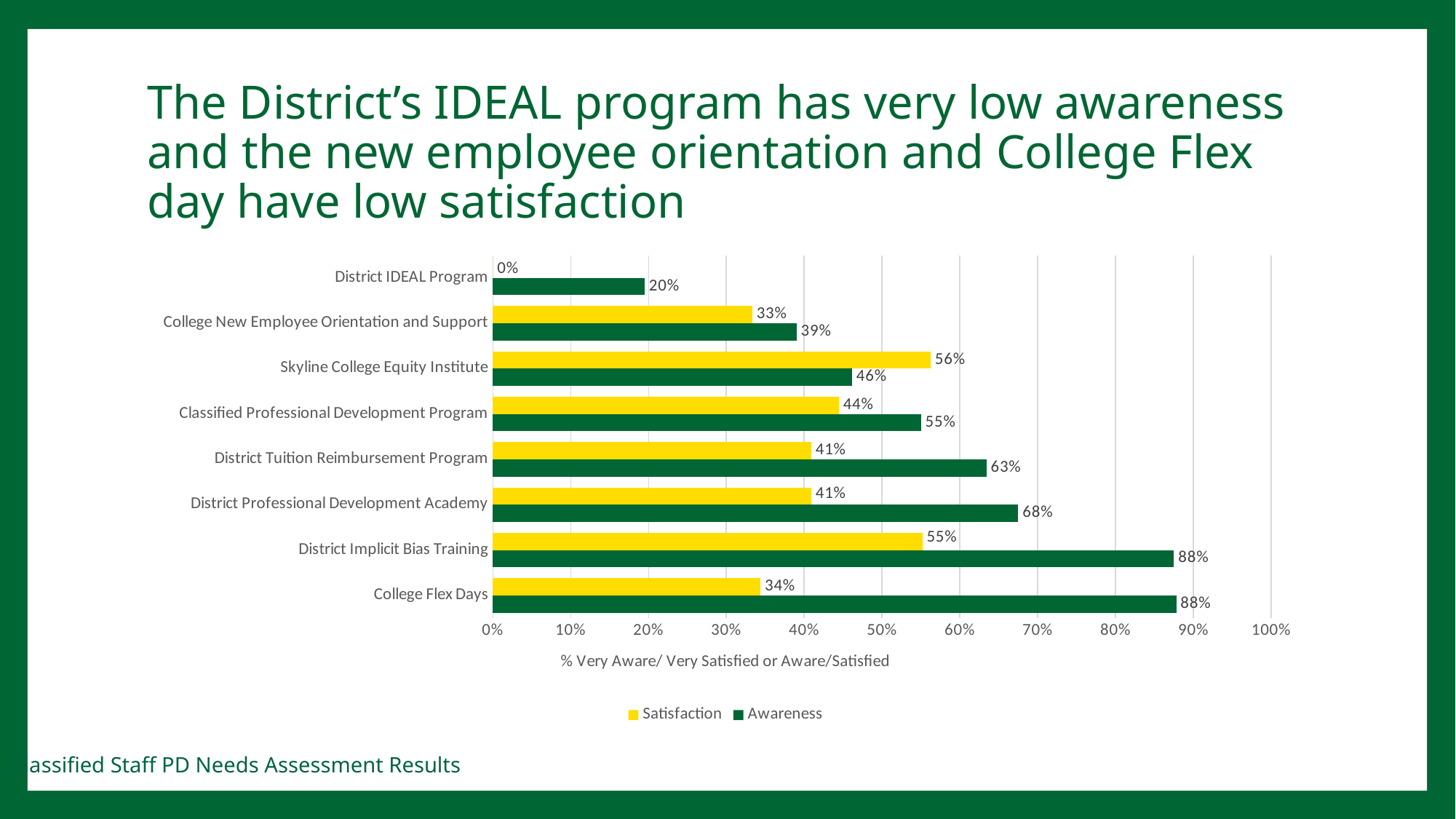
How many series does the legend list? 2 What is the x-axis title of the chart? % Very Aware/ Very Satisfied or Aware/Satisfied What kind of chart is shown on the slide? Bar chart Which category has the lowest Awareness value? District IDEAL Program What is the Satisfaction value for Skyline College Equity Institute? 56% How many categories are shown on the chart? 8 Which category has the highest Satisfaction value? Skyline College Equity Institute What is the Satisfaction value for College Flex Days? 34% What is the difference between the Awareness and Satisfaction values for District Implicit Bias Training? 33% What is the Awareness value for District Tuition Reimbursement Program? 63% What is the Awareness value for District IDEAL Program? 20% Which is larger for Classified Professional Development Program, Satisfaction or Awareness? Awareness